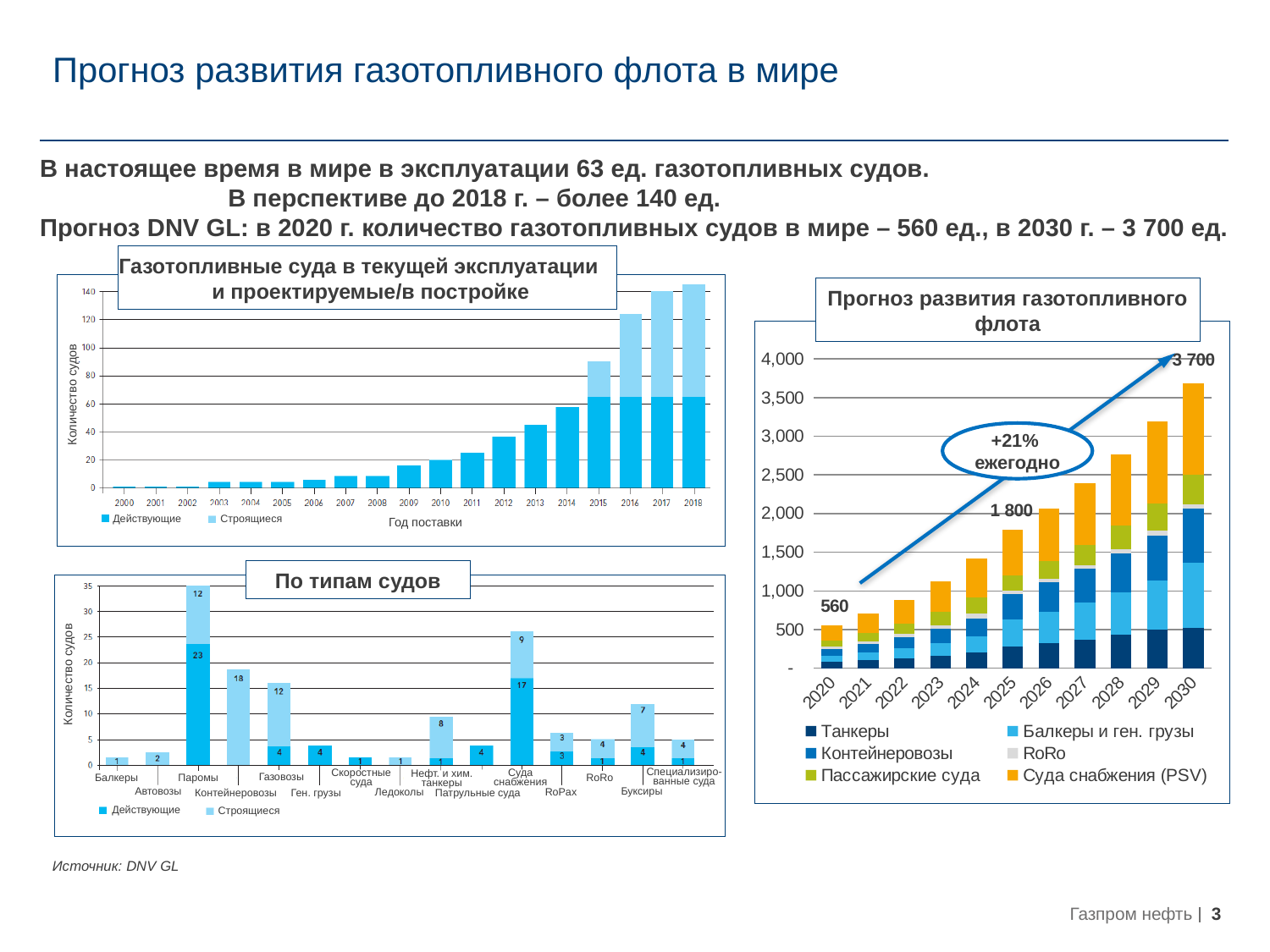
In the 'Прогноз развития газотопливного флота' chart, what is the total labelled for 2025? 1 800 In the 'По типам судов' chart, what is the 'Действующие' value for Паромы? 23 In the 'Прогноз развития газотопливного флота' chart, what is the difference between the 2030 total and the 2020 total? 3 140 What kind of chart is the 'Прогноз развития газотопливного флота' chart on the right? bar chart In the 'Прогноз развития газотопливного флота' chart, do the stacked totals rise or fall from 2020 to 2030? rise In the top-left chart 'Газотопливные суда в текущей эксплуатации и проектируемые/в постройке', is the total for 2015 greater or less than 100? less How many series does the legend of the 'Прогноз развития газотопливного флота' chart list? 6 In the 'По типам судов' chart, what is the 'Строящиеся' value for Суда снабжения? 9 How many years are shown on the x axis of the 'Прогноз развития газотопливного флота' chart? 11 What annual growth rate is annotated on the 'Прогноз развития газотопливного флота' chart? +21% ежегодно In the 'Прогноз развития газотопливного флота' chart, what is the total number of vessels shown for 2030? 3 700 In the 'Прогноз развития газотопливного флота' chart, what is the total number of vessels shown for 2020? 560